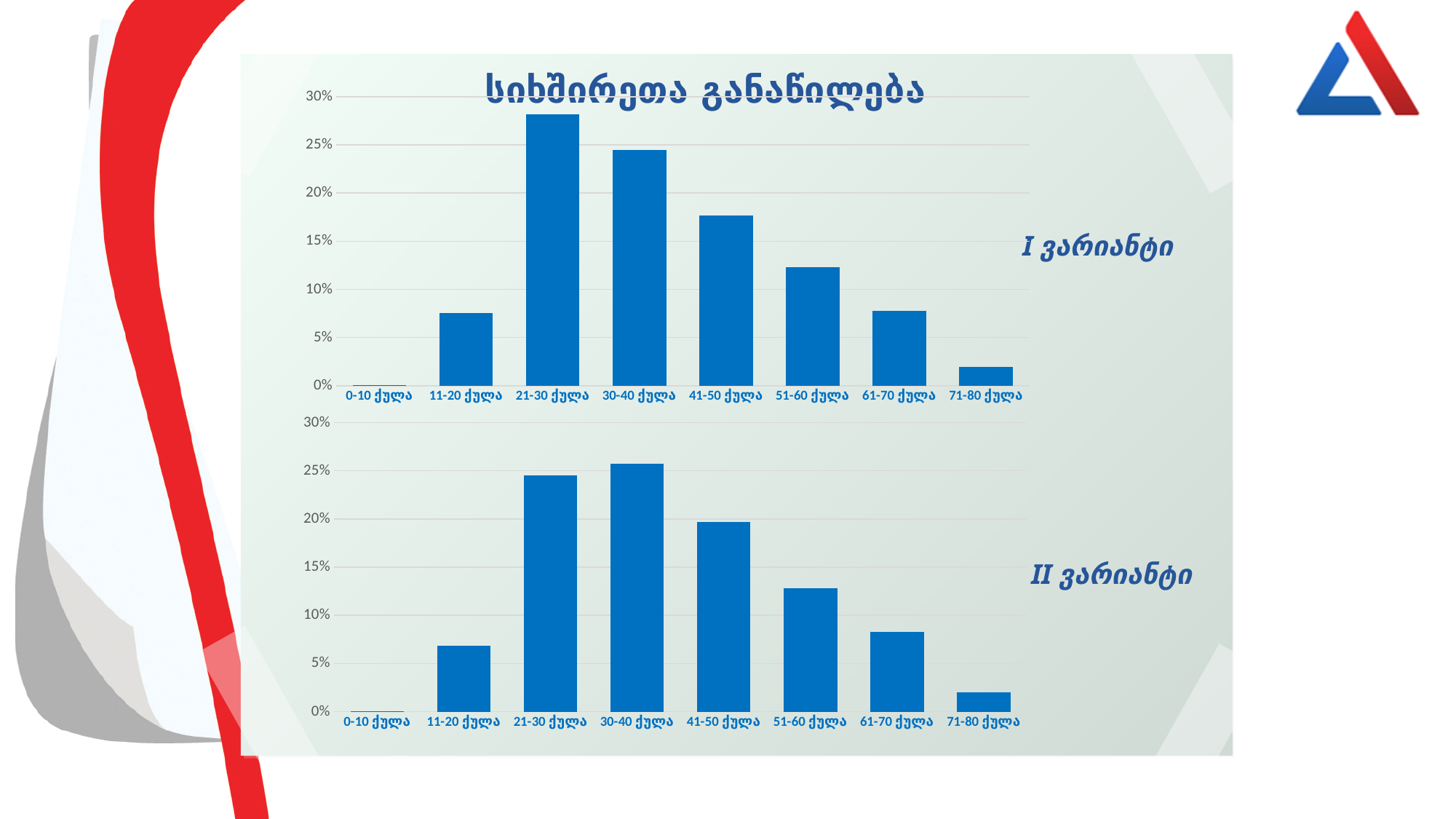
In the top chart (I ვარიანტი), is the value for 21-30 ქულა greater or less than 25%? greater In the top chart (I ვარიანტი), which category has the highest value? 21-30 ქულა In the bottom chart (II ვარიანტი), which category has the highest value? 30-40 ქულა What is the title shown above the charts? სიხშირეთა განაწილება In the top chart (I ვარიანტი), do the values rise or fall from 30-40 ქულა to 71-80 ქულა? fall How many categories are shown on the x axis of the bottom chart (II ვარიანტი)? 8 In the top chart (I ვარიანტი), which is larger: the value for 41-50 ქულა or the value for 51-60 ქულა? 41-50 ქულა In the bottom chart (II ვარიანტი), is the value for 51-60 ქულა greater or less than 10%? greater What kind of chart is the top chart (I ვარიანტი)? bar chart In the top chart (I ვარიანტი), which category has the lowest value? 0-10 ქულა In the bottom chart (II ვარიანტი), which is larger: the value for 11-20 ქულა or the value for 71-80 ქულა? 11-20 ქულა